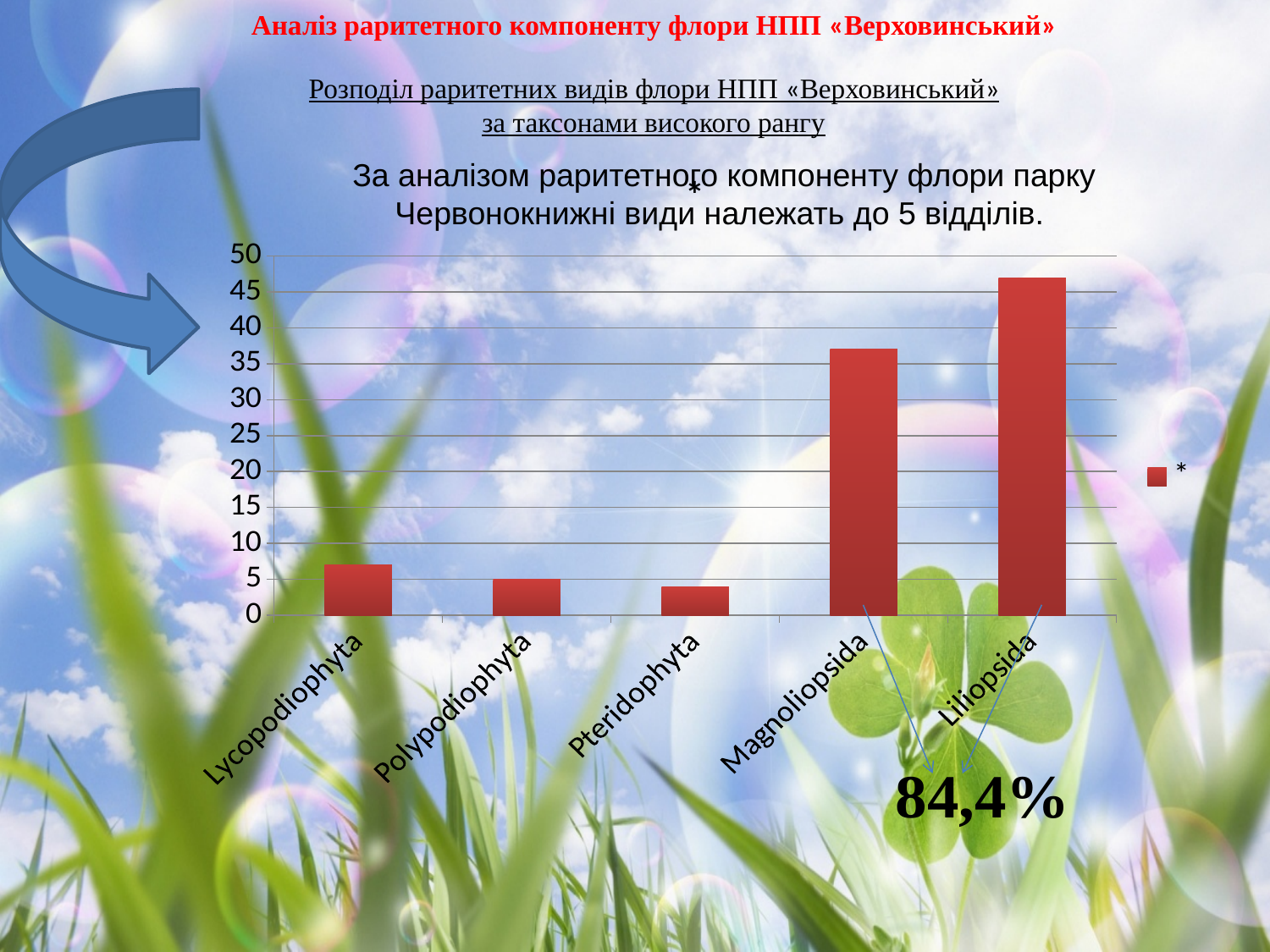
What percentage is written below the Magnoliopsida and Liliopsida bars on the slide? 84,4% Which category has the highest bar in the chart? Liliopsida Is the value for Magnoliopsida greater or less than 35? greater Which category has the lowest bar in the chart? Pteridophyta Which is larger, the value for Magnoliopsida or the value for Liliopsida? Liliopsida Which is larger, the value for Lycopodiophyta or the value for Pteridophyta? Lycopodiophyta Is the value for Lycopodiophyta greater or less than 10? less How many series does the chart legend list? 1 Is the value for Magnoliopsida greater or less than 40? less How many categories are plotted on the x axis of the chart? 5 What kind of chart is shown on the slide? bar chart